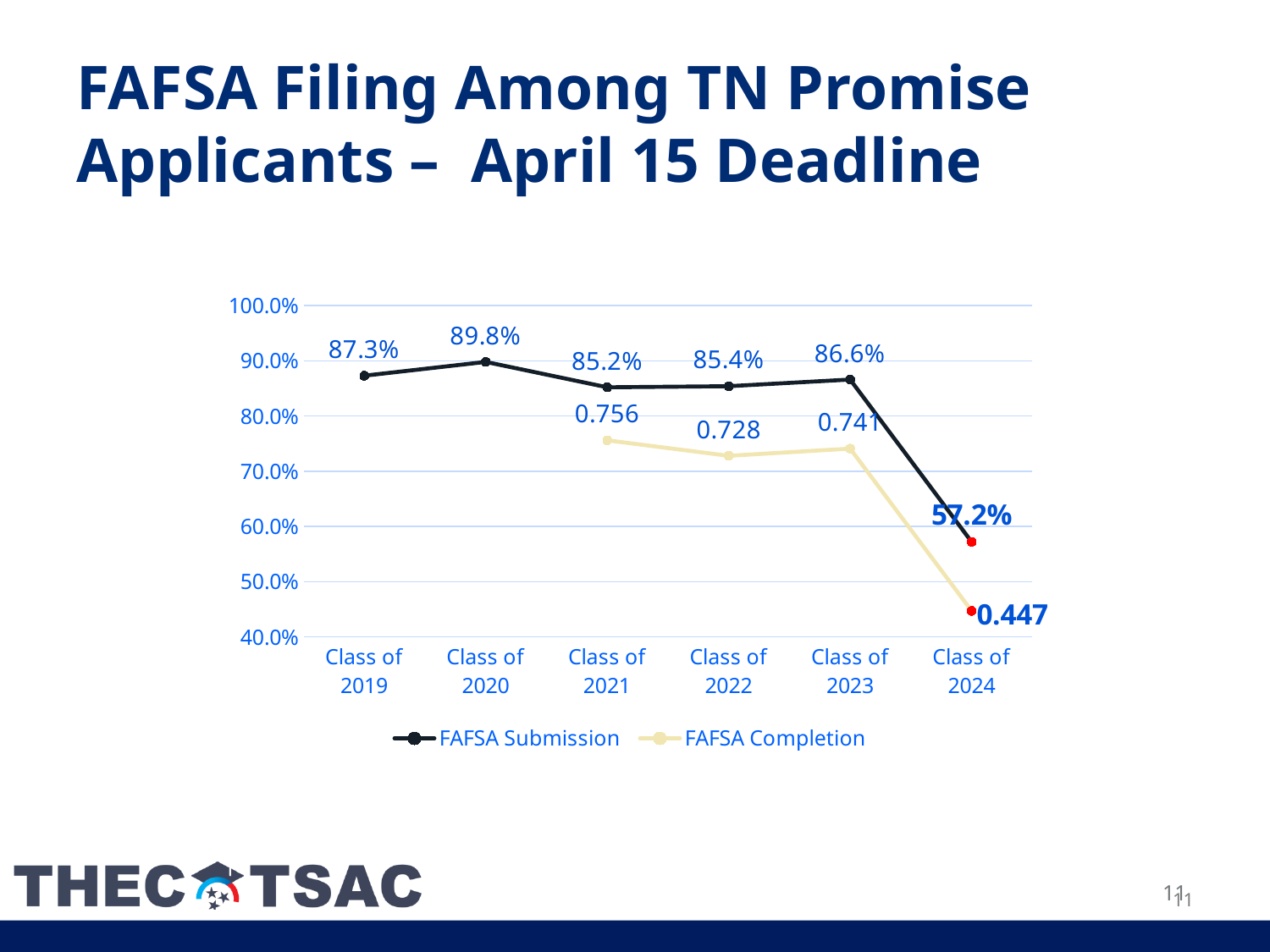
What is the difference between the FAFSA Submission values for the Class of 2023 and the Class of 2024? 29.4% Is the FAFSA Completion value for the Class of 2024 greater or less than 50.0%? less Which class has the highest FAFSA Submission value? Class of 2020 What is the FAFSA Submission value for the Class of 2019? 87.3% Which class has the lowest FAFSA Completion value? Class of 2024 How many series does the legend list? 2 What kind of chart is shown on the slide? line chart Does the FAFSA Completion series rise or fall from the Class of 2023 to the Class of 2024? fall Which is larger, the FAFSA Submission value for the Class of 2021 or for the Class of 2023? Class of 2023 What is the FAFSA Completion value for the Class of 2022? 0.728 How many classes are shown on the x axis? 6 What is the FAFSA Submission value for the Class of 2024? 57.2%